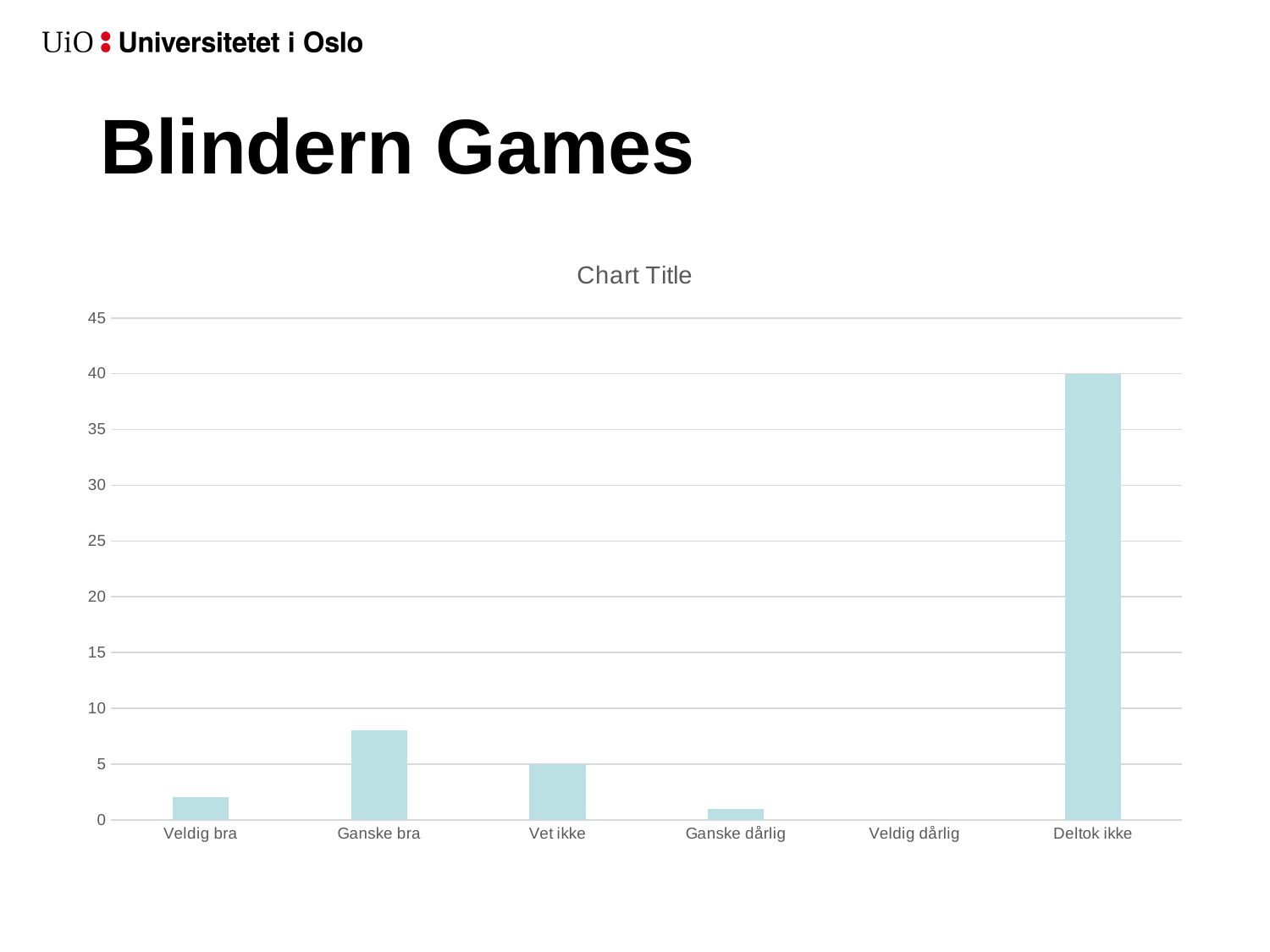
What is the difference between the values for Deltok ikke and Vet ikke? 35 Is the value for Veldig bra greater or less than 5? less Which is larger, the value for Ganske bra or the value for Vet ikke? Ganske bra How many categories are shown on the x axis of the chart? 6 What is the value for Vet ikke? 5 What is the value for Deltok ikke? 40 Is the value for Ganske bra greater or less than 10? less Is the value for Deltok ikke greater or less than 35? greater What kind of chart is shown on the slide? bar chart Which category has the lowest value in the chart? Veldig dårlig What is the title shown above the chart? Chart Title Which category has the highest value in the chart? Deltok ikke